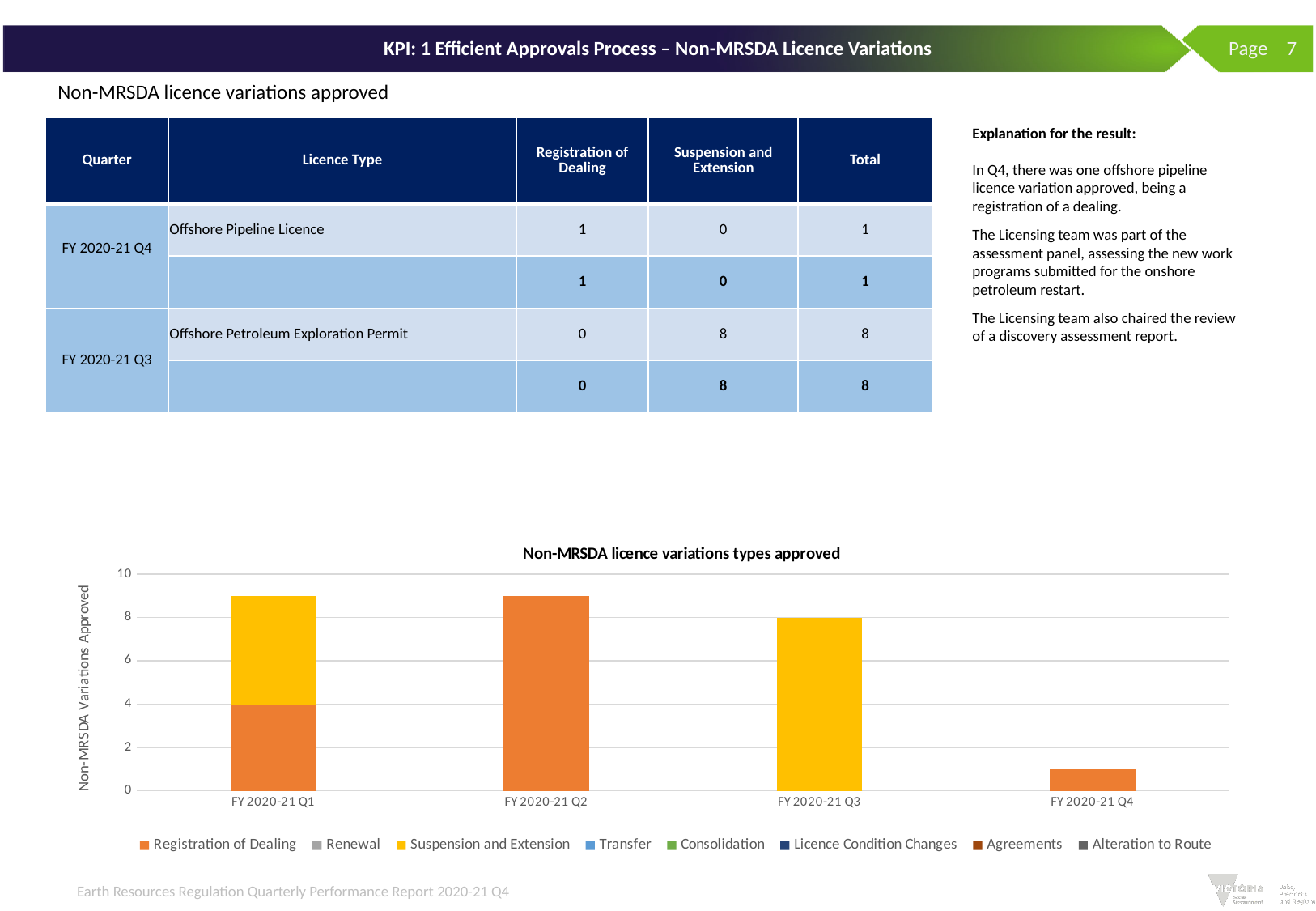
Is the total bar for FY 2020-21 Q2 greater or less than 8? greater In the chart, what is the value for Registration of Dealing in FY 2020-21 Q1? 4 Which quarter has the larger total bar, FY 2020-21 Q3 or FY 2020-21 Q4? FY 2020-21 Q3 Is the bar for FY 2020-21 Q4 greater or less than 2? less In the chart, what is the value for Suspension and Extension in FY 2020-21 Q3? 8 How many series does the chart legend list? 8 What colour represents Suspension and Extension in the chart legend? Yellow From FY 2020-21 Q3 to FY 2020-21 Q4, does the total bar rise or fall? fall Which quarter has the lowest total bar in the chart? FY 2020-21 Q4 How many quarters are shown on the x axis of the chart? 4 What is the title of the chart? Non-MRSDA licence variations types approved What kind of chart is shown on the slide? Stacked bar chart